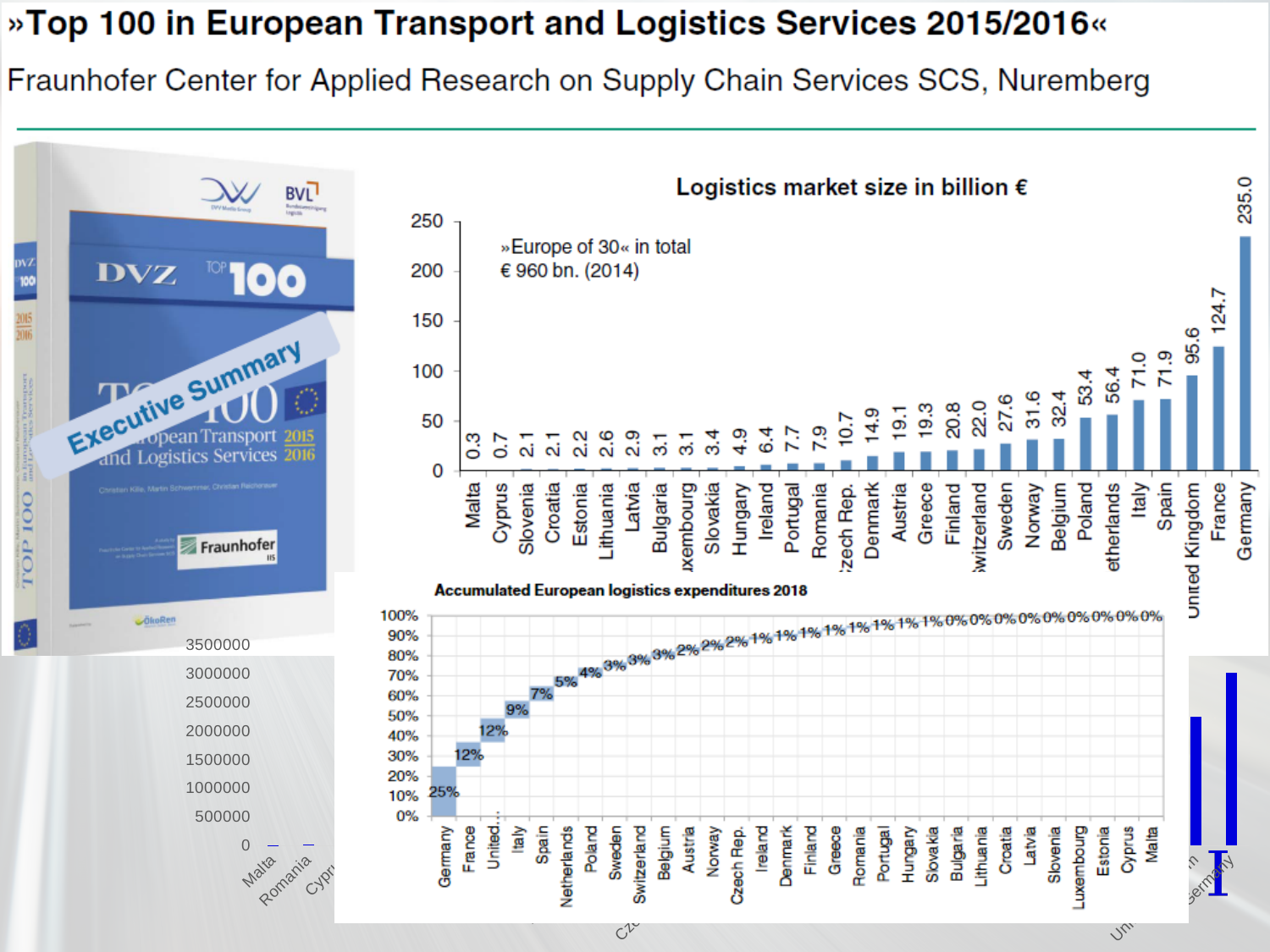
In the 'Logistics market size in billion €' chart, do the values rise or fall from left to right? Rise In the 'Logistics market size in billion €' chart, how many countries are shown? 30 In the 'Logistics market size in billion €' chart, which is larger, the value for Italy or the value for Netherlands? Italy In the 'Logistics market size in billion €' chart, what is the value for Poland? 53.4 In the 'Logistics market size in billion €' chart, what is the value for France? 124.7 In the 'Accumulated European logistics expenditures 2018' chart, what percentage is shown for Spain? 7% In the 'Logistics market size in billion €' chart, which country has the highest value? Germany In the 'Logistics market size in billion €' chart, which country has the lowest value? Malta What kind of chart is the 'Logistics market size in billion €' chart? Bar chart In the 'Logistics market size in billion €' chart, what is the value for Germany? 235.0 In the 'Accumulated European logistics expenditures 2018' chart, what percentage is shown for Germany? 25% In the 'Logistics market size in billion €' chart, what is the difference between Germany and France? 110.3